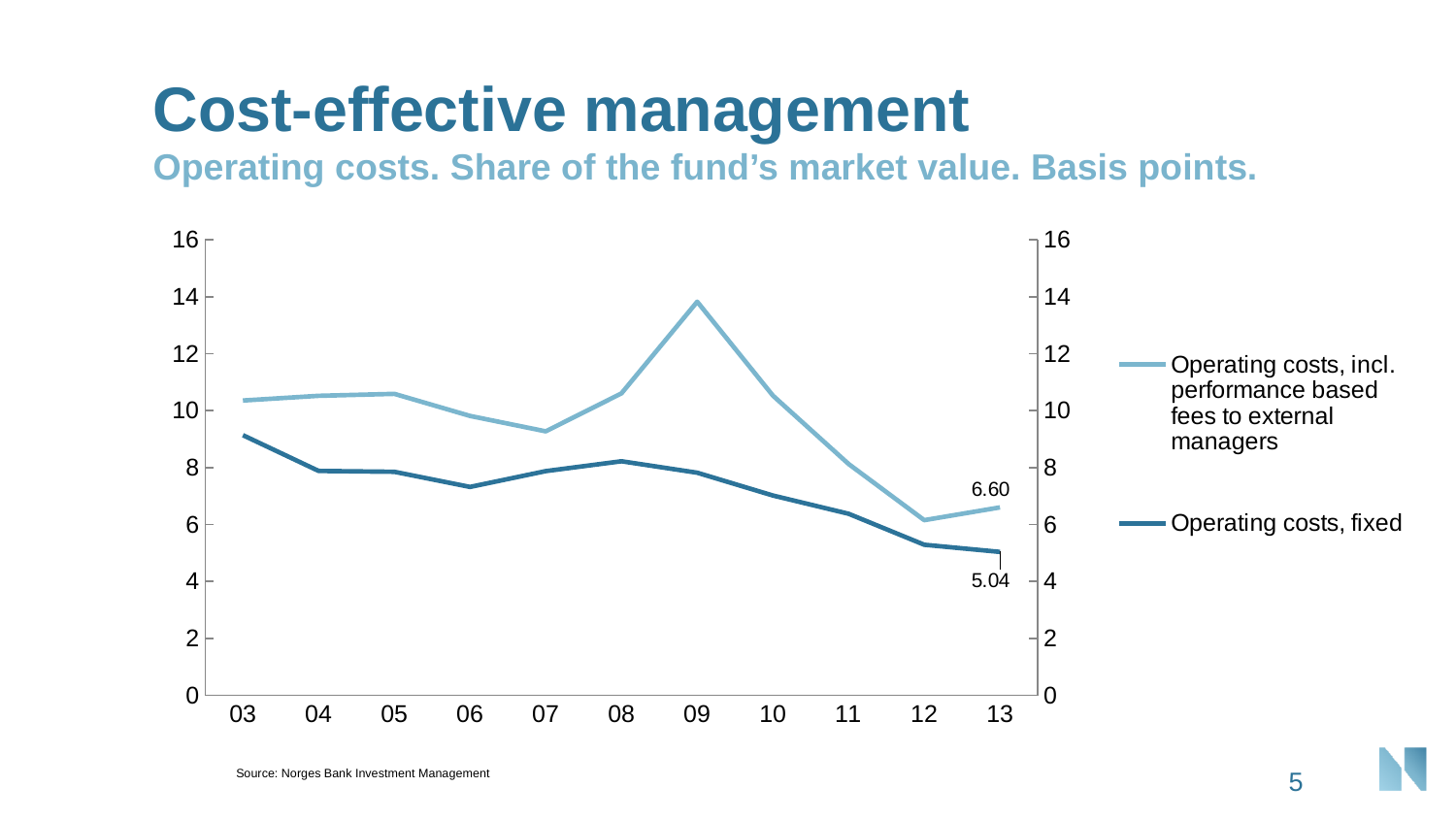
Is the value for 'Operating costs, incl. performance based fees to external managers' in 09 greater or less than 12? greater In which year does 'Operating costs, fixed' reach its lowest value? 13 In which year does 'Operating costs, incl. performance based fees to external managers' reach its highest value? 09 How many series does the legend list? 2 What is the value for 'Operating costs, fixed' in 13? 5.04 What is the value for 'Operating costs, incl. performance based fees to external managers' in 13? 6.60 What kind of chart is shown on the slide? Line chart How many years are shown on the x axis? 11 Which series has the higher value in 09? Operating costs, incl. performance based fees to external managers Does 'Operating costs, fixed' rise or fall from 09 to 13? Fall What is the difference between the two series' values in 13? 1.56 Is the value for 'Operating costs, fixed' in 03 greater or less than 8? greater